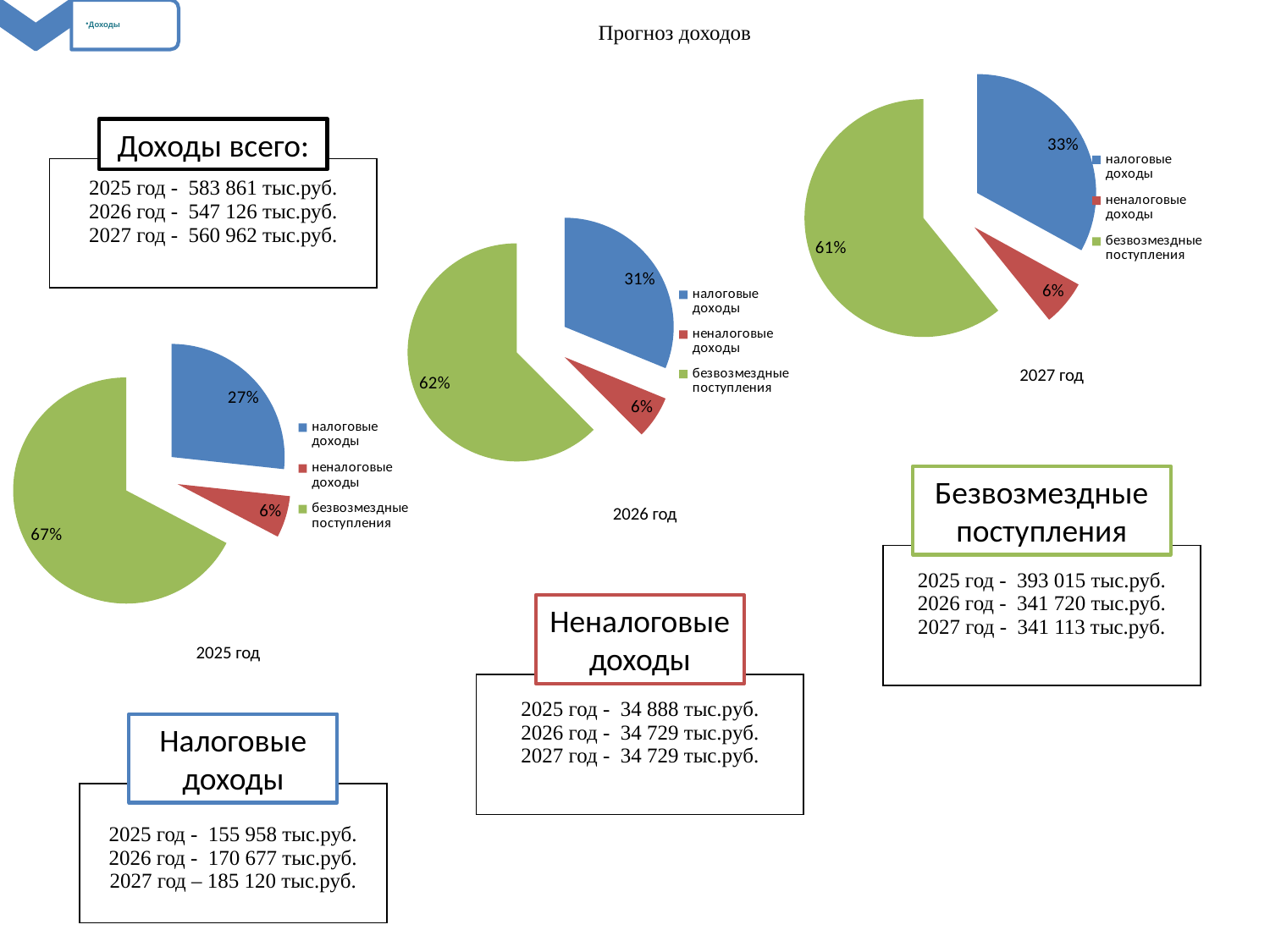
What type of chart is used for "2027 год"? Pie chart In the "2026 год" pie chart, what share is shown for "налоговые доходы"? 31% How many slices does the "2025 год" pie chart have? 3 In the "2025 год" pie chart, which category has the smallest slice? неналоговые доходы How many entries does the legend of the "2026 год" chart list? 3 In the "2025 год" pie chart, what share is shown for "безвозмездные поступления"? 67% In the "2027 год" pie chart, what share is shown for "неналоговые доходы"? 6% In the "2026 год" pie chart, which category has the largest slice? безвозмездные поступления In the "2025 год" pie chart, what share is shown for "налоговые доходы"? 27% Which is larger in the "2026 год" pie chart: the share of "налоговые доходы" or the share of "неналоговые доходы"? налоговые доходы In the "2027 год" pie chart, what share is shown for "безвозмездные поступления"? 61% In the "2027 год" pie chart, what is the difference between the shares of "безвозмездные поступления" and "налоговые доходы"? 28%